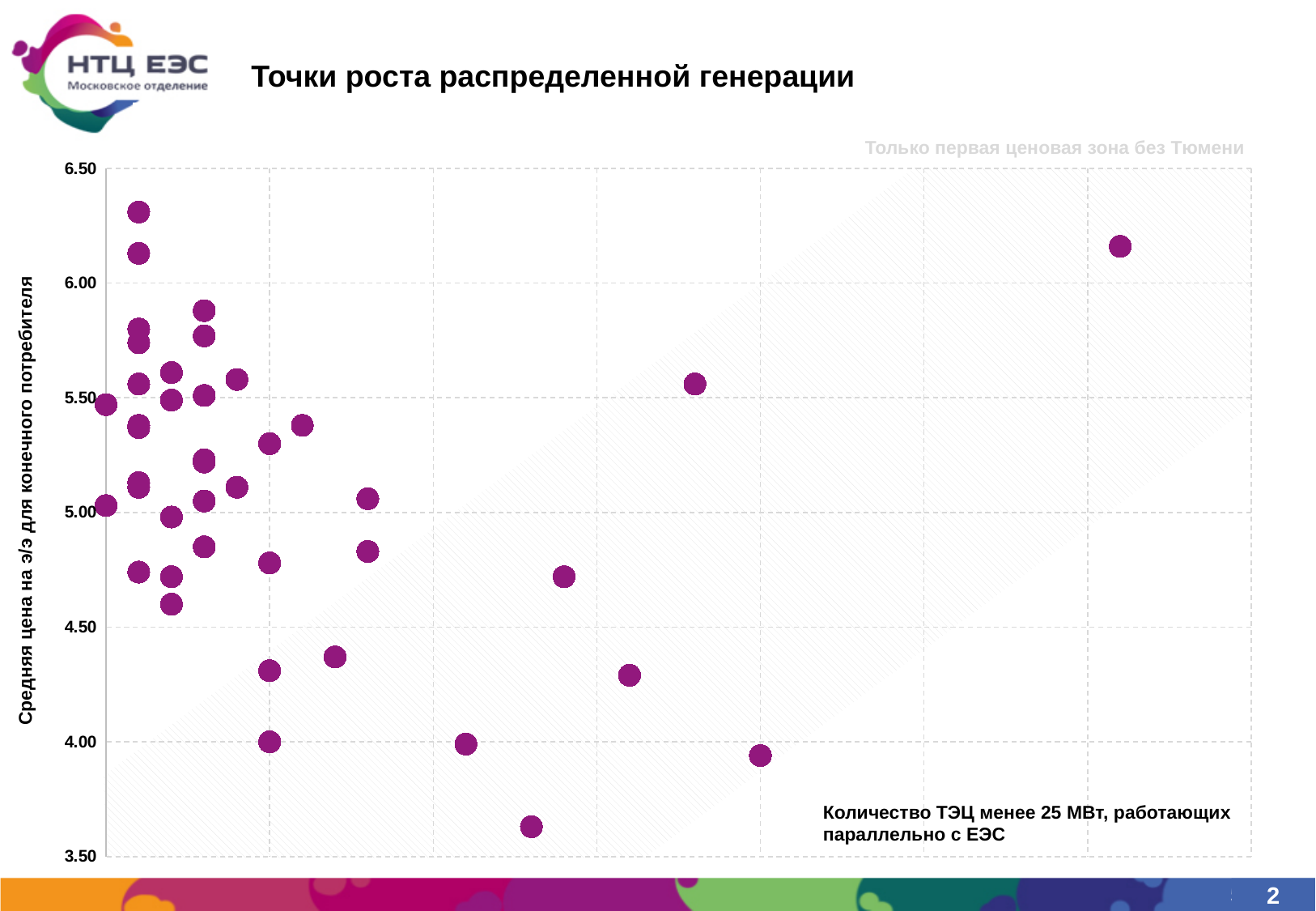
What is the title of the chart on the slide? Точки роста распределенной генерации What is the lowest value shown on the vertical axis of the chart? 3.50 Is the value of the highest point on the chart greater or less than 6.00? greater What is the label of the vertical axis of the chart? Средняя цена на э/э для конечного потребителя Is the value of the rightmost point on the chart greater or less than 6.00? greater What kind of chart is shown on the slide? scatter chart Is the value of the lowest point on the chart greater or less than 4.00? less